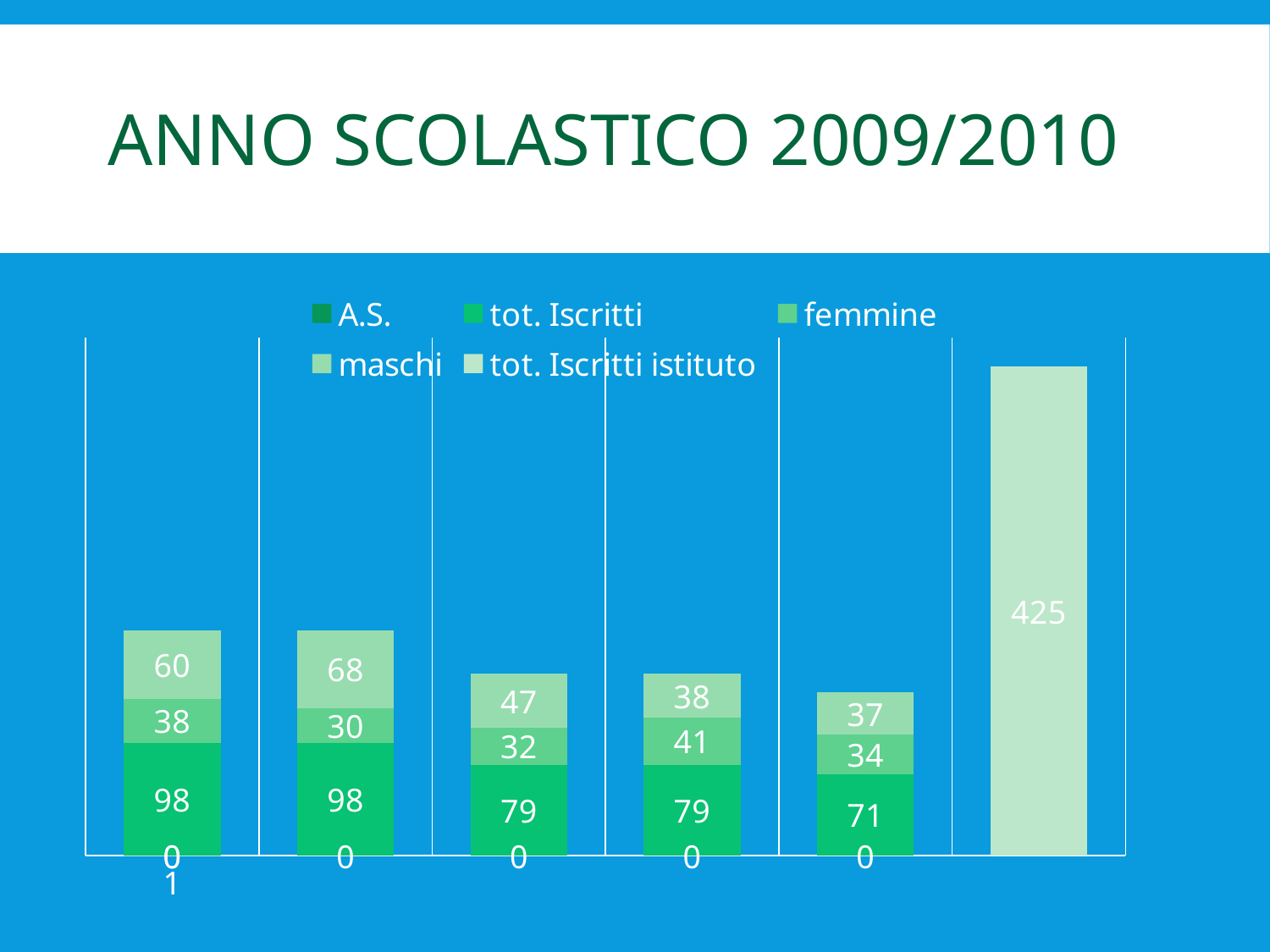
How many bars are plotted in the chart? 6 Which is larger in the first bar (category 1): the 'maschi' segment or the 'femmine' segment? maschi Which bar is the tallest in the chart? the rightmost bar (425) What is the value of the 'femmine' segment for category 1 (the first bar)? 38 What kind of chart is shown on the slide? stacked bar chart What is the value of the 'A.S.' series for category 1 (the first bar)? 0 What is the total of the stacked segments in the first bar (category 1)? 196 What is the value of the 'maschi' segment for category 1 (the first bar)? 60 What is the difference between the 'maschi' and 'femmine' segments in the first bar (category 1)? 22 What is the value of the 'tot. Iscritti' segment for category 1 (the first bar)? 98 How many series does the legend list? 5 What is the value labelled on the rightmost bar ('tot. Iscritti istituto')? 425